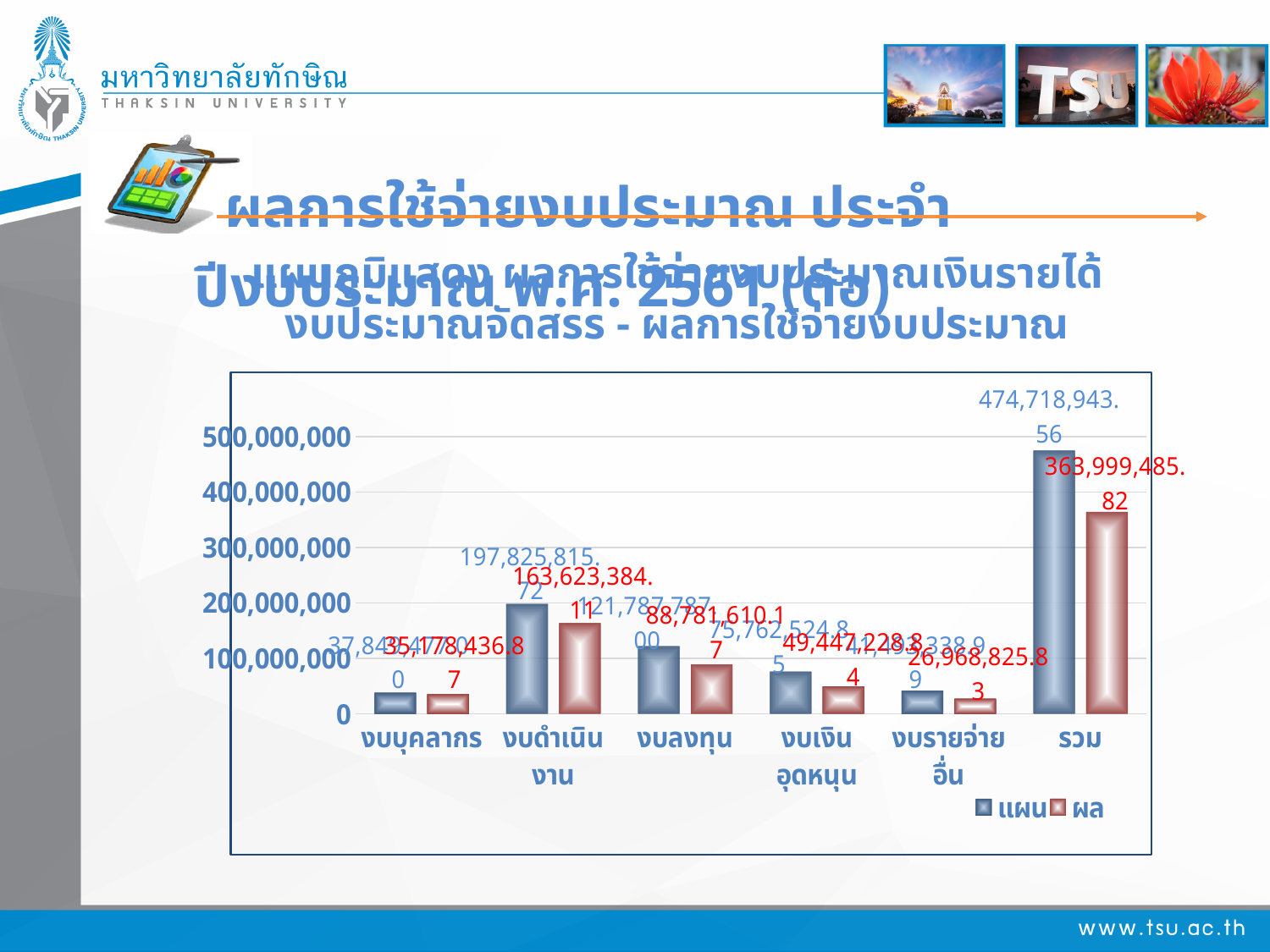
What is the แผน value for รวม? 474,718,943.56 What is the difference between the แผน and ผล values for รวม? 110,719,457.74 What kind of chart is shown on the slide? bar chart For งบดำเนินงาน, which is larger, แผน or ผล? แผน How many series does the legend list? 2 Is the แผน value for งบลงทุน greater or less than 100,000,000? greater How many categories are shown on the x axis? 6 What is the ผล value for รวม? 363,999,485.82 Which category has the lowest ผล value? งบรายจ่ายอื่น Which category has the highest แผน value? รวม What is the แผน value for งบดำเนินงาน? 197,825,815.72 What is the ผล value for งบดำเนินงาน? 163,623,384.11